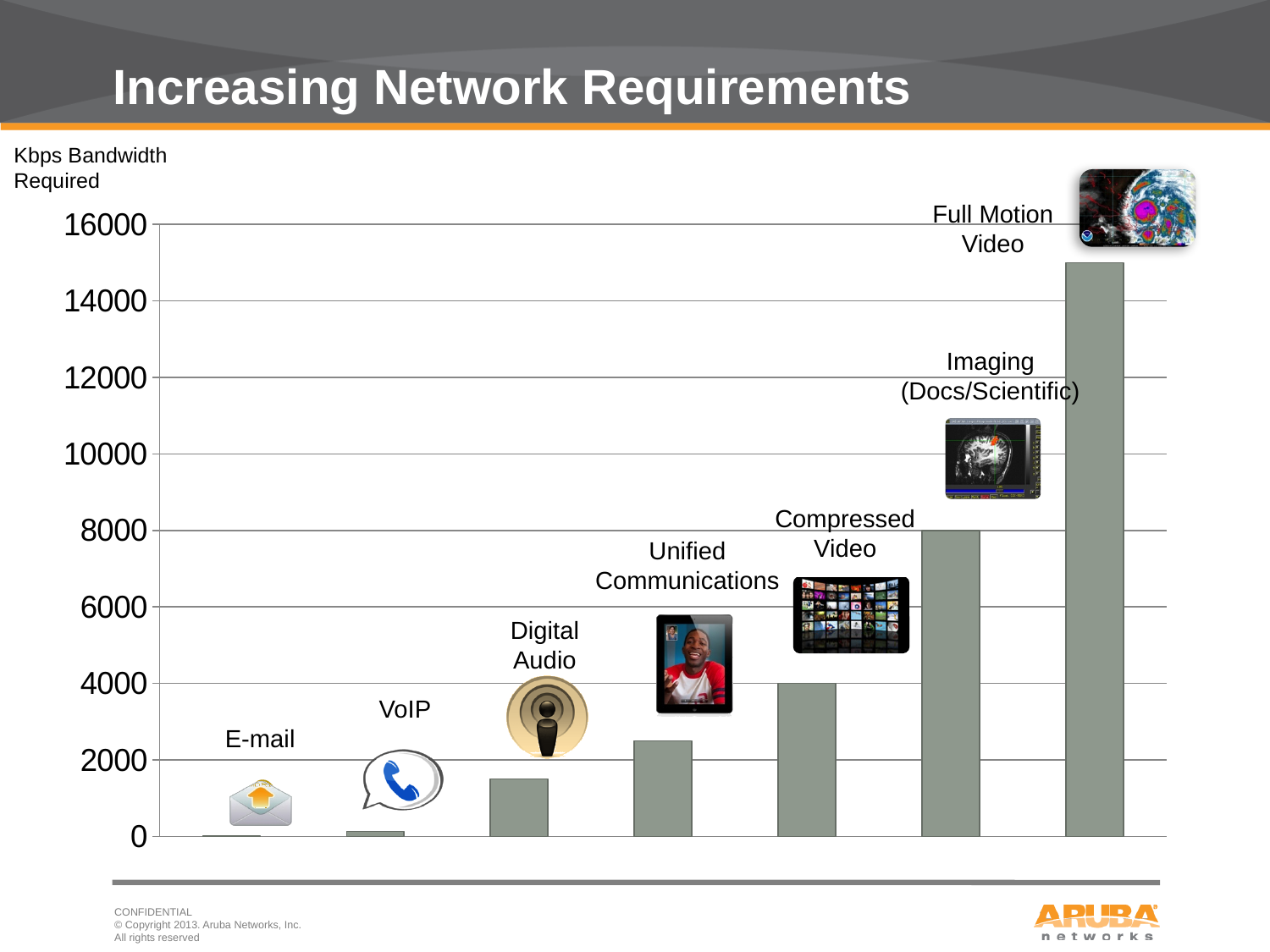
Is the value for Unified Communications greater or less than 2000? greater What is the Kbps bandwidth required for Compressed Video? 4000 Is the value for Full Motion Video greater or less than 14000? greater Which category requires the lowest Kbps bandwidth? E-mail Which requires more bandwidth, Imaging (Docs/Scientific) or Compressed Video? Imaging (Docs/Scientific) Is the value for Digital Audio greater or less than 2000? less Do the bar values rise or fall from left to right across the categories? rise Which category requires the highest Kbps bandwidth? Full Motion Video How many categories (bars) are plotted in the chart? 7 What kind of chart is shown on the slide? bar chart What is the Kbps bandwidth required for Imaging (Docs/Scientific)? 8000 What is the difference in Kbps bandwidth between Imaging (Docs/Scientific) and Compressed Video? 4000